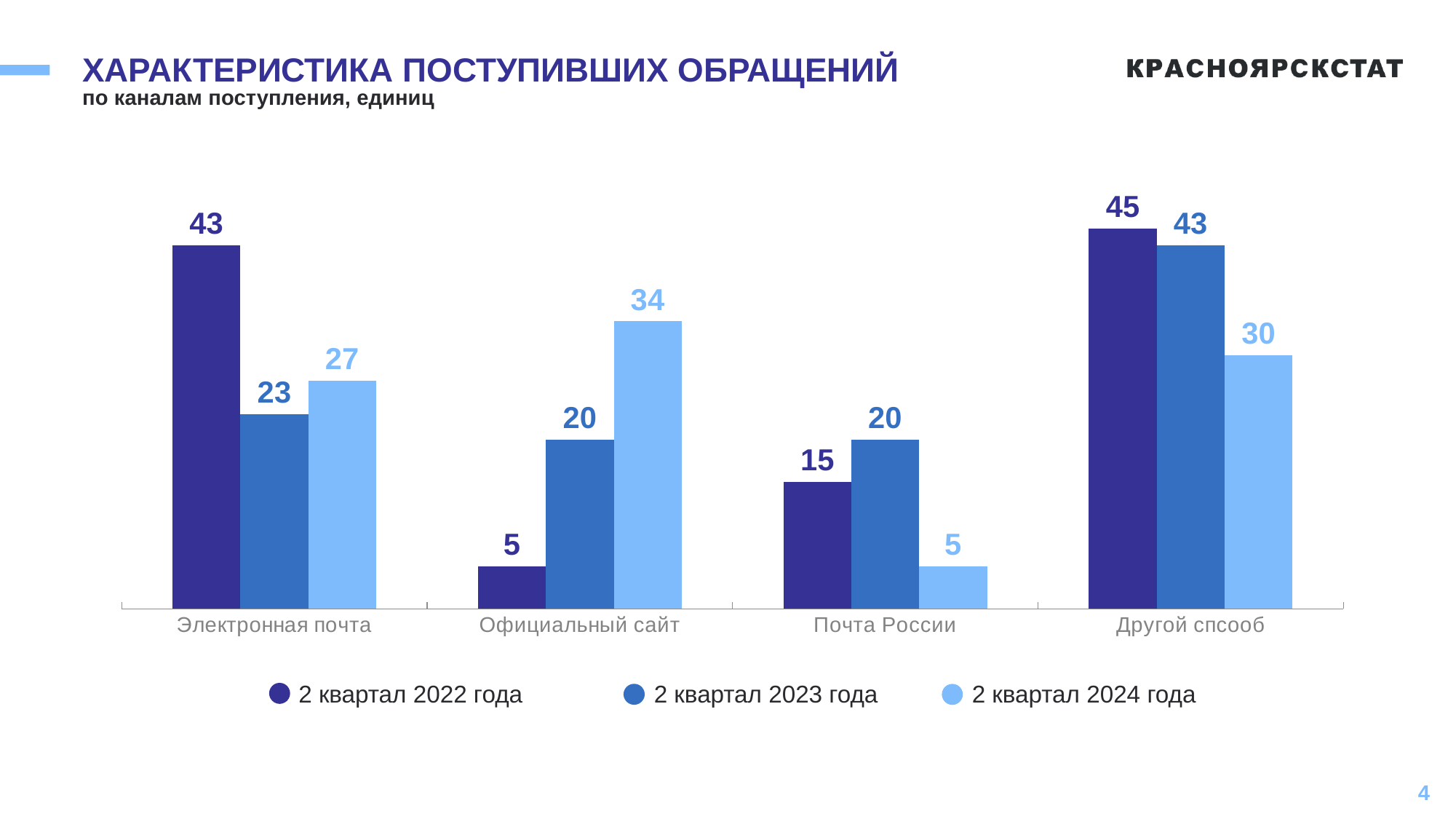
What is the value for Почта России in 2 квартал 2023 года? 20 Which is larger for Официальный сайт: the value for 2 квартал 2023 года or 2 квартал 2024 года? 2 квартал 2024 года What is the difference between the 2 квартал 2022 года and 2 квартал 2023 года values for Электронная почта? 20 What kind of chart is shown on the slide? bar chart How many categories are shown on the x axis? 4 What is the value for Электронная почта in 2 квартал 2022 года? 43 What is the value for Официальный сайт in 2 квартал 2024 года? 34 What is the subtitle under the chart title? по каналам поступления, единиц How many series does the legend list? 3 What is the value for Другой спсооб in 2 квартал 2024 года? 30 Which category has the lowest value in 2 квартал 2024 года? Почта России Which category has the highest value in 2 квартал 2022 года? Другой спсооб